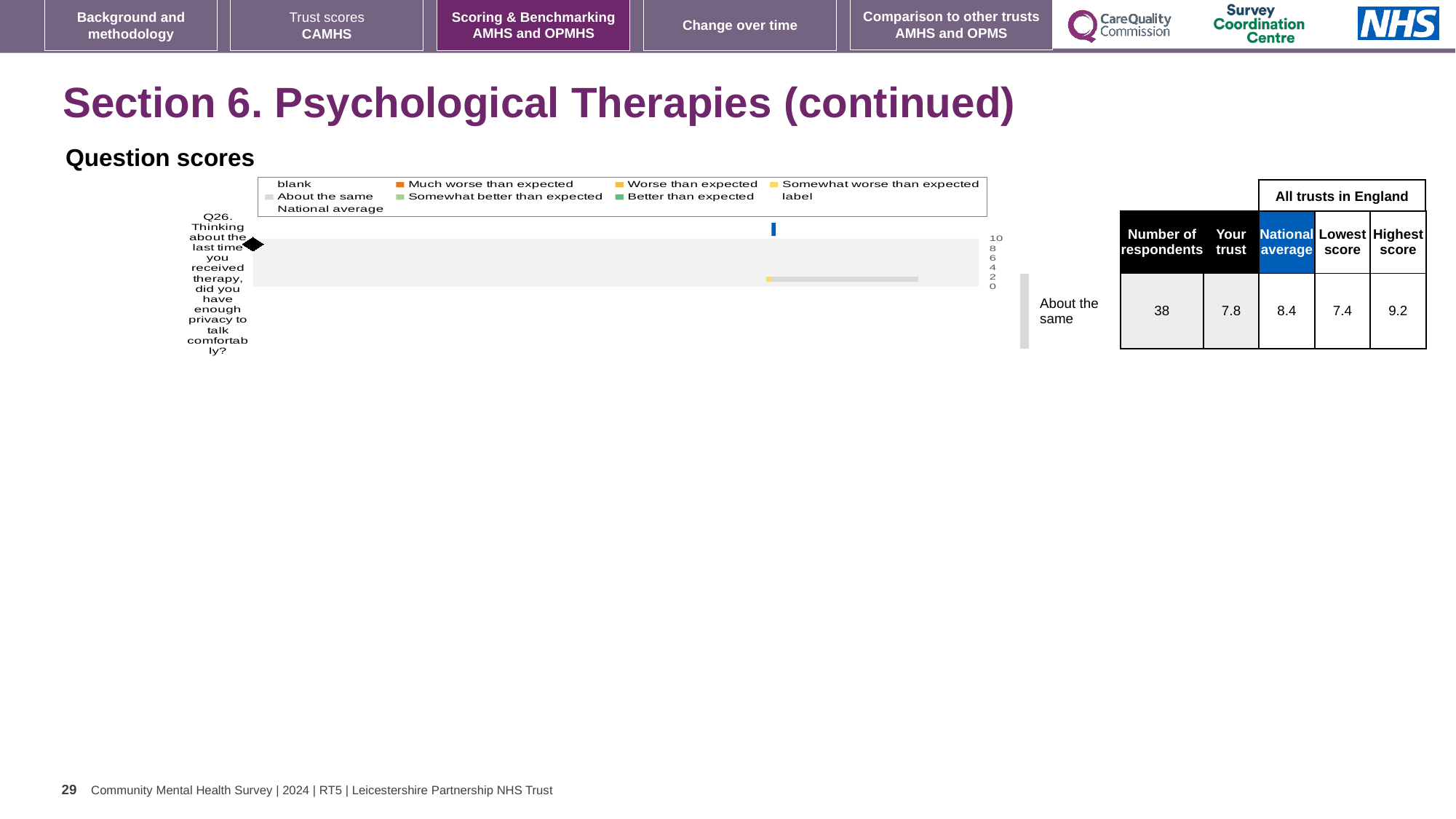
Which question number is plotted in the chart? Q26 What is the 'Your trust' score for Q26? 7.8 What is the difference between the national average and the 'Your trust' score for Q26? 0.6 What benchmark category is shown for Q26 next to the chart? About the same How many questions (categories) are plotted in the chart? 1 What is the highest score among all trusts in England for Q26? 9.2 What kind of chart is shown under 'Question scores'? bar chart What is the lowest score among all trusts in England for Q26? 7.4 What is the difference between the highest and lowest scores for Q26 across all trusts in England? 1.8 What is the national average score for Q26? 8.4 Which is larger for Q26, the 'Your trust' score or the national average? National average How many respondents answered Q26? 38